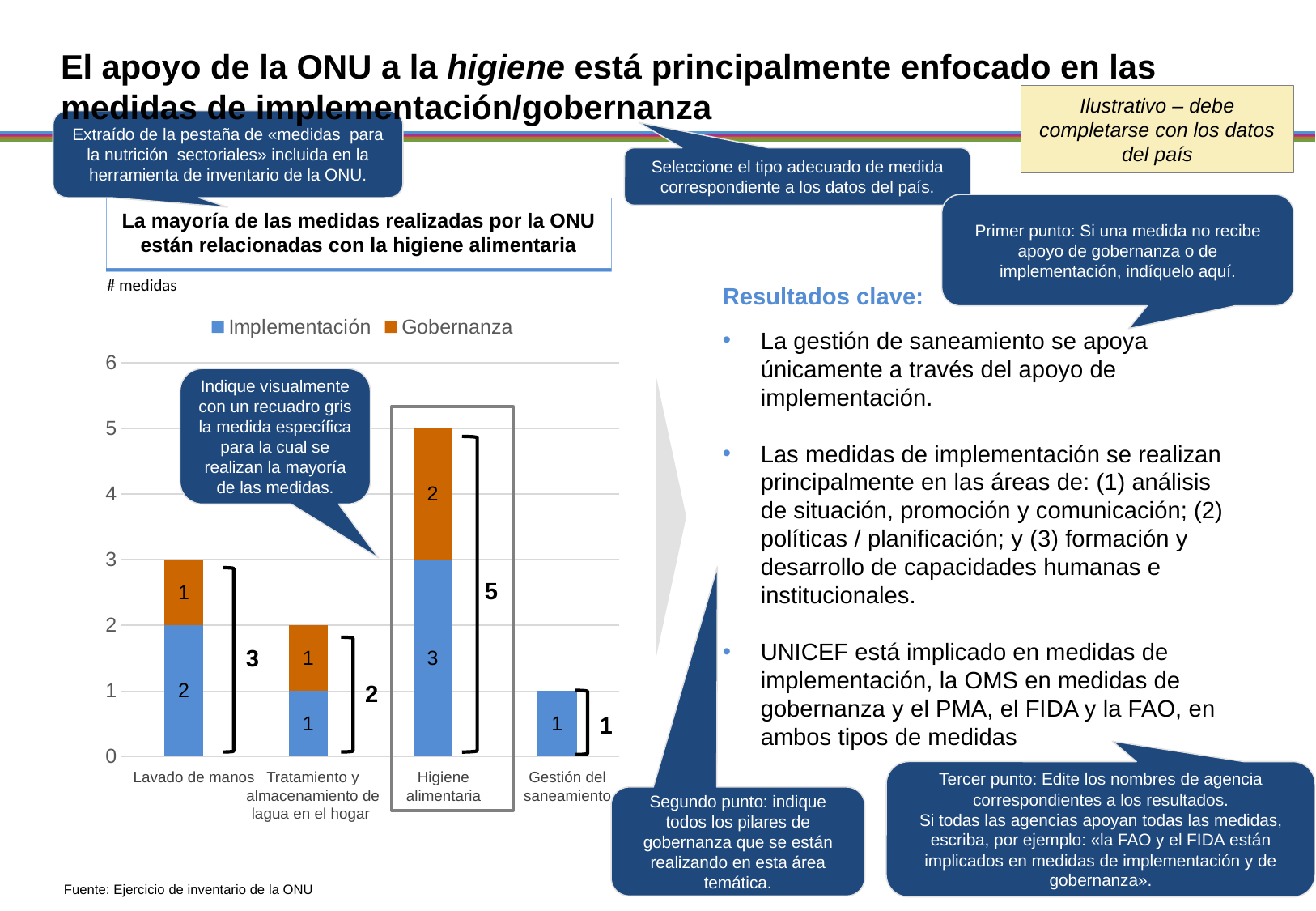
Which category has the highest total number of measures? Higiene alimentaria What is the total number of measures for Higiene alimentaria? 5 What is the Implementación value for Gestión del saneamiento? 1 What is the total number of measures for Tratamiento y almacenamiento de agua en el hogar? 2 Which category has the lowest total number of measures? Gestión del saneamiento What is the Gobernanza value for Lavado de manos? 1 How many series does the chart legend list? 2 How many categories are shown on the x axis of the chart? 4 What is the Implementación value for Higiene alimentaria? 3 Which is larger: the Gobernanza value for Higiene alimentaria or the Gobernanza value for Tratamiento y almacenamiento de agua en el hogar? Higiene alimentaria What type of chart is shown on the slide? Stacked bar chart What is the difference between the Implementación value for Higiene alimentaria and the Implementación value for Lavado de manos? 1